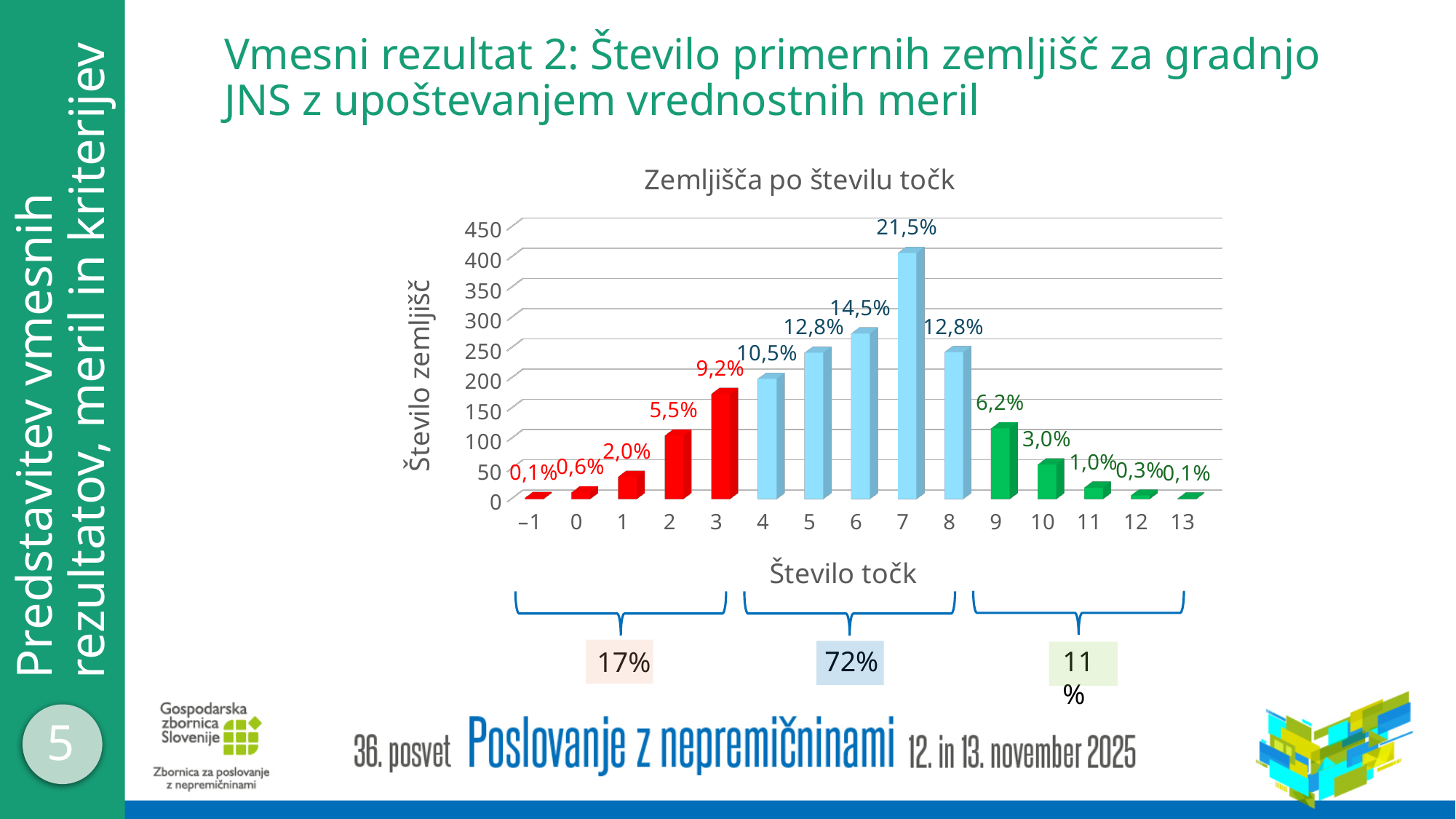
What is the title of the chart? Zemljišča po številu točk How many categories (point values) are shown on the x axis of the chart? 15 What kind of chart is shown on the slide? bar chart What is the data label shown for the bar at 3 points? 9,2% What is the data label shown for the bar at 7 points? 21,5% What is the data label shown for the bar at 10 points? 3,0% Is the value for 4 points greater or less than 250? less Which number of points has the highest bar in the chart? 7 What is the difference between the data labels for 7 points and 6 points? 7,0% Is the value for 7 points greater or less than 350? greater What percentage is shown under the bracket grouping the blue bars (4 to 8 points)? 72% Which bar is taller: the one for 3 points or the one for 9 points? 3 points